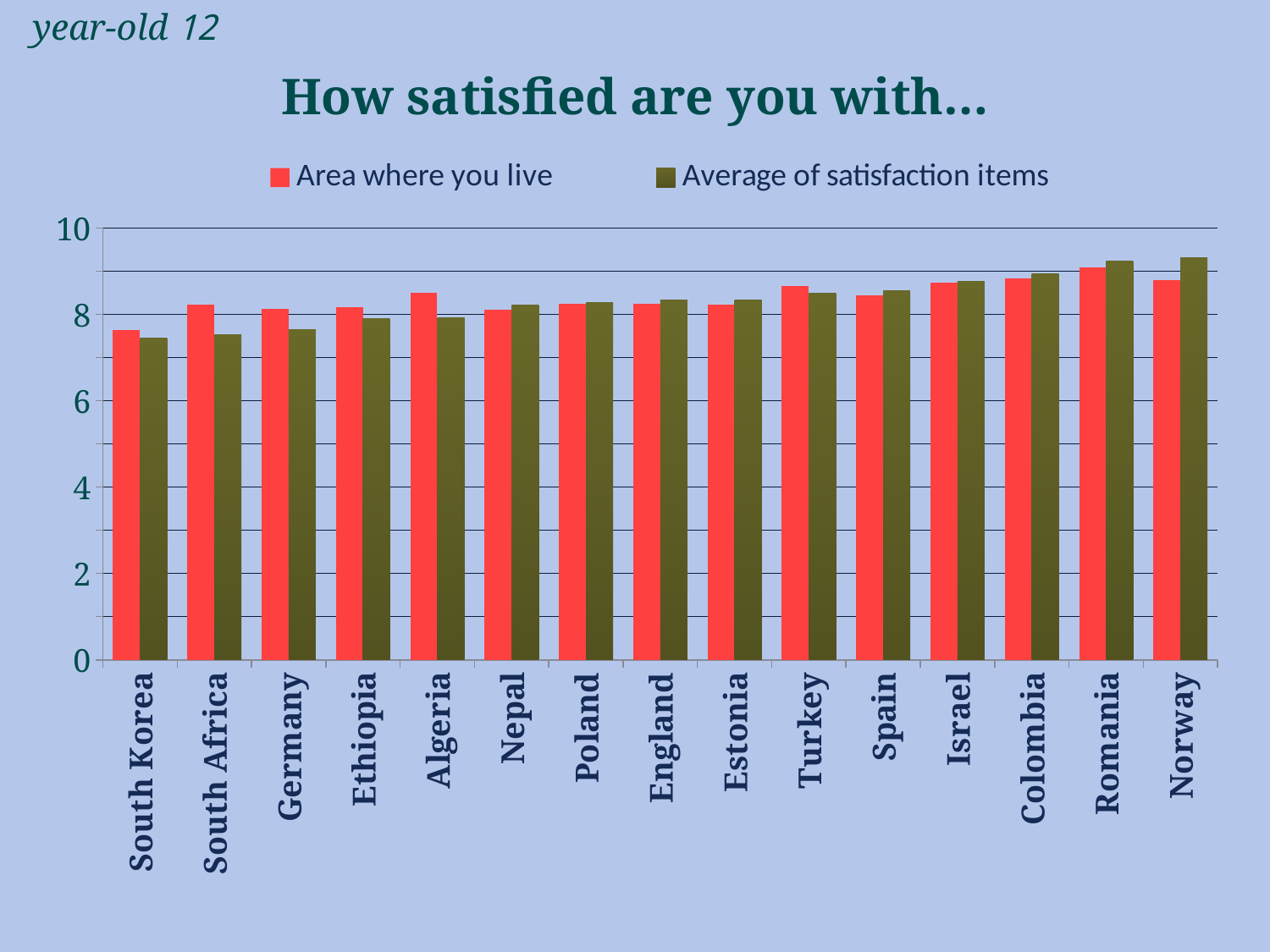
Which country has the lowest value for 'Area where you live'? South Korea How many series does the chart's legend list? 2 For Algeria, which is larger: 'Area where you live' or 'Average of satisfaction items'? Area where you live Is the 'Average of satisfaction items' value for Norway greater or less than 8? greater For Norway, which is larger: 'Area where you live' or 'Average of satisfaction items'? Average of satisfaction items How many countries are shown on the x axis of the chart? 15 Which country has the highest value for 'Area where you live'? Romania Is the 'Area where you live' value for South Africa greater or less than 8? greater Is the 'Average of satisfaction items' value for South Korea greater or less than 8? less Do the 'Average of satisfaction items' values generally rise or fall from left to right across the countries? rise What kind of chart is shown on the slide? bar chart What is the title of the chart? How satisfied are you with...